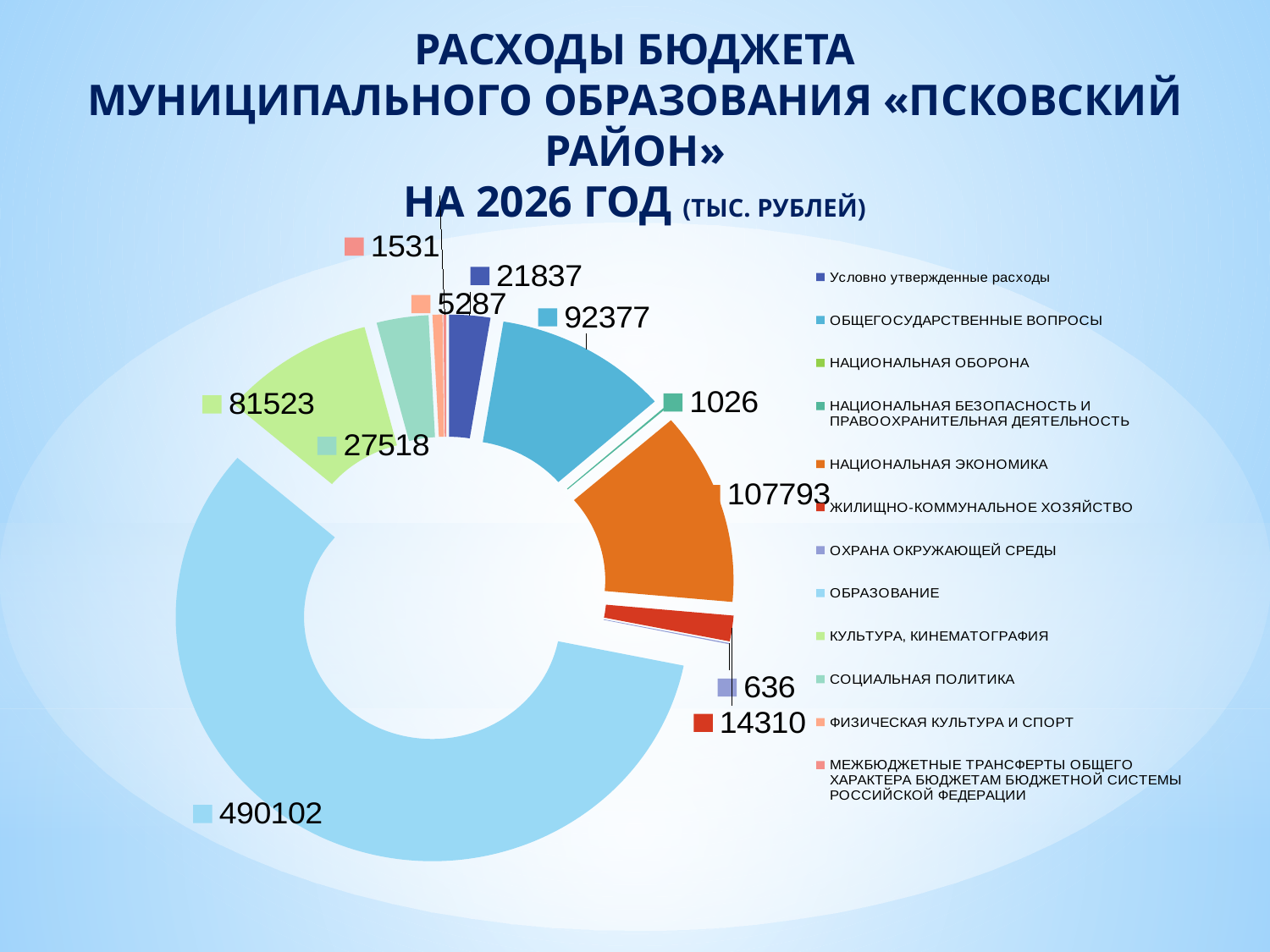
What is the value for ОХРАНА ОКРУЖАЮЩЕЙ СРЕДЫ? 636 What kind of chart is shown on the slide? Doughnut (pie) chart What is the value for НАЦИОНАЛЬНАЯ ЭКОНОМИКА? 107793 In what units are the values on the chart given, according to the title? тыс. рублей Which category has the largest share of the budget expenditures? ОБРАЗОВАНИЕ How many categories does the legend list? 12 What is the value for КУЛЬТУРА, КИНЕМАТОГРАФИЯ? 81523 What is the value for ОБРАЗОВАНИЕ? 490102 Which is larger, КУЛЬТУРА, КИНЕМАТОГРАФИЯ or СОЦИАЛЬНАЯ ПОЛИТИКА? КУЛЬТУРА, КИНЕМАТОГРАФИЯ What is the difference between НАЦИОНАЛЬНАЯ ЭКОНОМИКА and ОБЩЕГОСУДАРСТВЕННЫЕ ВОПРОСЫ? 15416 What is the value for ОБЩЕГОСУДАРСТВЕННЫЕ ВОПРОСЫ? 92377 What is the value for ЖИЛИЩНО-КОММУНАЛЬНОЕ ХОЗЯЙСТВО? 14310